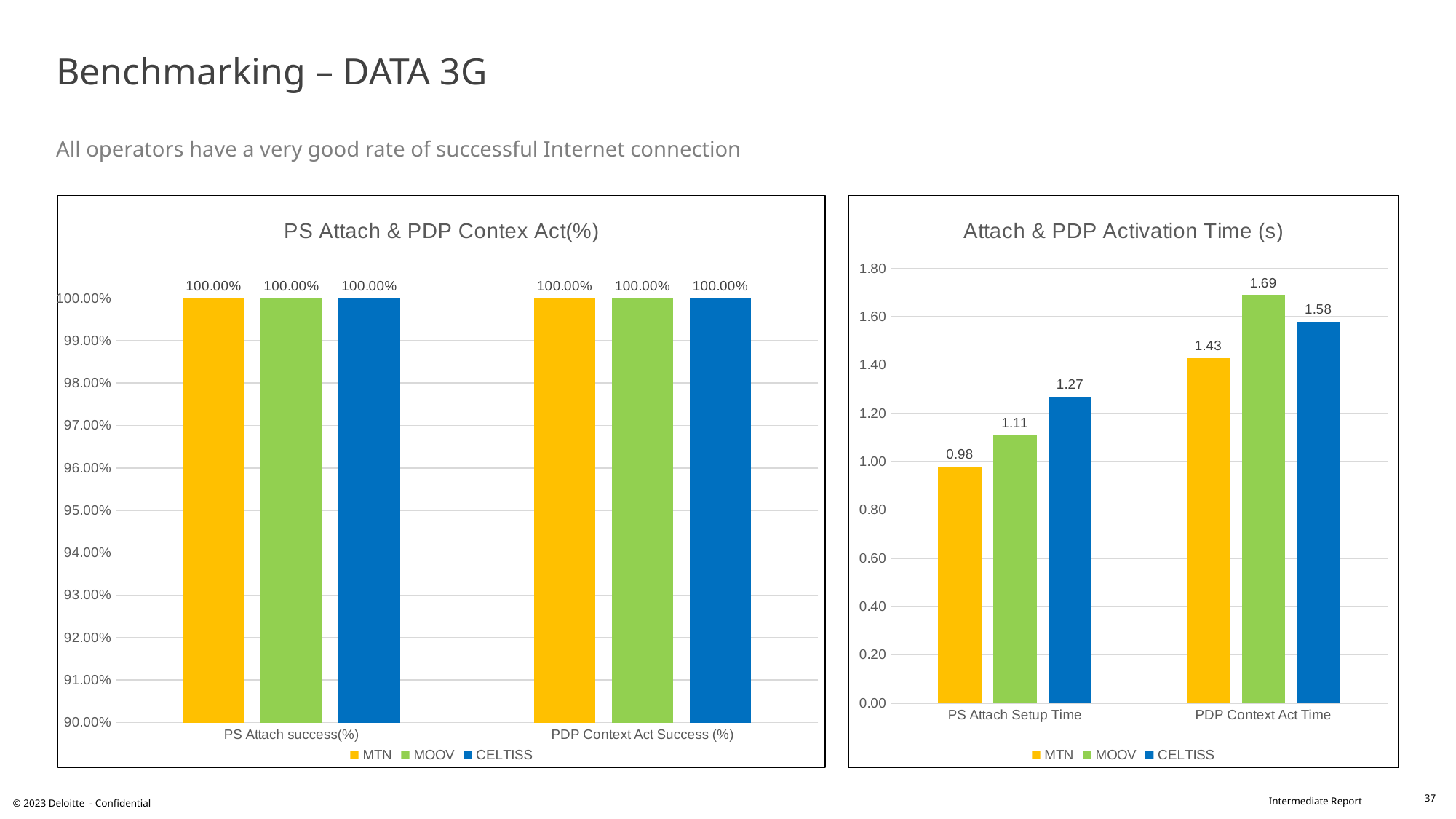
In the 'Attach & PDP Activation Time (s)' chart, which is larger: MOOV's PDP Context Act Time or CELTISS's PDP Context Act Time? MOOV's PDP Context Act Time How many series does the legend of the 'Attach & PDP Activation Time (s)' chart list? 3 In the 'Attach & PDP Activation Time (s)' chart, what is the PS Attach Setup Time for MTN? 0.98 What kind of chart is the 'Attach & PDP Activation Time (s)' chart? Bar chart In the 'Attach & PDP Activation Time (s)' chart, which operator has the highest PDP Context Act Time? MOOV In the 'Attach & PDP Activation Time (s)' chart, which operator has the lowest PS Attach Setup Time? MTN In the 'PS Attach & PDP Contex Act(%)' chart, what is the PS Attach success(%) for MOOV? 100.00% In the 'PS Attach & PDP Contex Act(%)' chart, what is the PDP Context Act Success (%) for CELTISS? 100.00% In the 'Attach & PDP Activation Time (s)' chart, what is the PS Attach Setup Time for CELTISS? 1.27 How many categories are shown on the x axis of the 'PS Attach & PDP Contex Act(%)' chart? 2 In the 'Attach & PDP Activation Time (s)' chart, what is the PDP Context Act Time for MOOV? 1.69 In the 'Attach & PDP Activation Time (s)' chart, what is the difference between CELTISS's and MTN's PS Attach Setup Time? 0.29